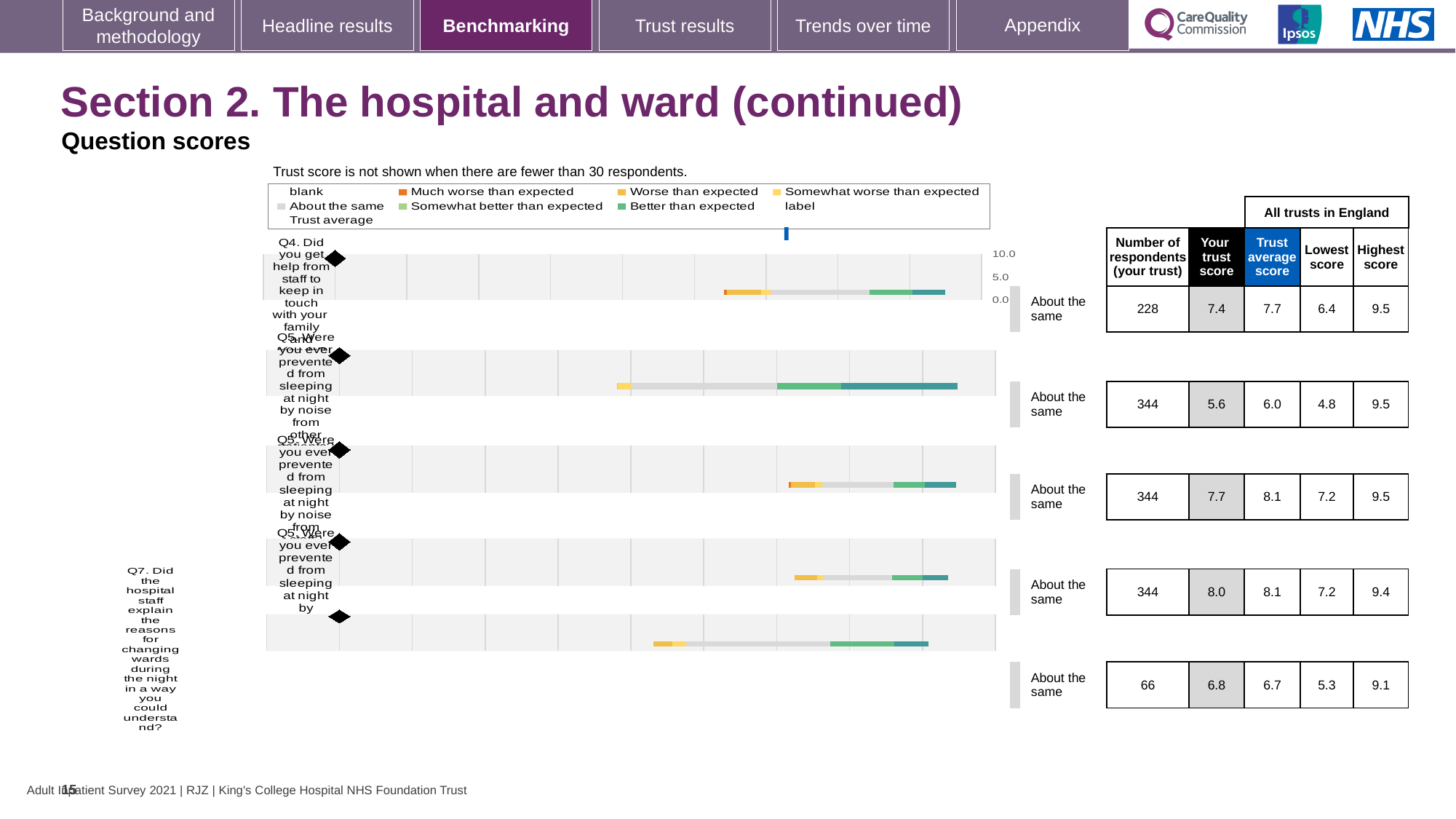
How many question rows (bar charts) are shown on the slide? 5 For the top row (Q4), what is the difference between the 'Trust average score' and 'Your trust score'? 0.3 What is the 'Lowest score' for the second row in the table? 4.8 In the table beside the charts, what is 'Your trust score' for the top row (Q4)? 7.4 What kind of chart is used to show the question scores on this slide? bar chart For the bottom row (Q7), which is larger: 'Your trust score' or the 'Trust average score'? Your trust score (6.8) Which row in the table has the lowest number of respondents? the bottom row (Q7), 66 In the table beside the charts, what is the number of respondents for the top row (Q4)? 228 In the table beside the charts, what is the 'Highest score' for the bottom row (Q7)? 9.1 Which row in the table has the highest 'Your trust score'? the fourth row, 8.0 In the table beside the charts, what is the 'Trust average score' for the bottom row (Q7)? 6.7 What benchmark label is shown next to the top bar chart (Q4)? About the same